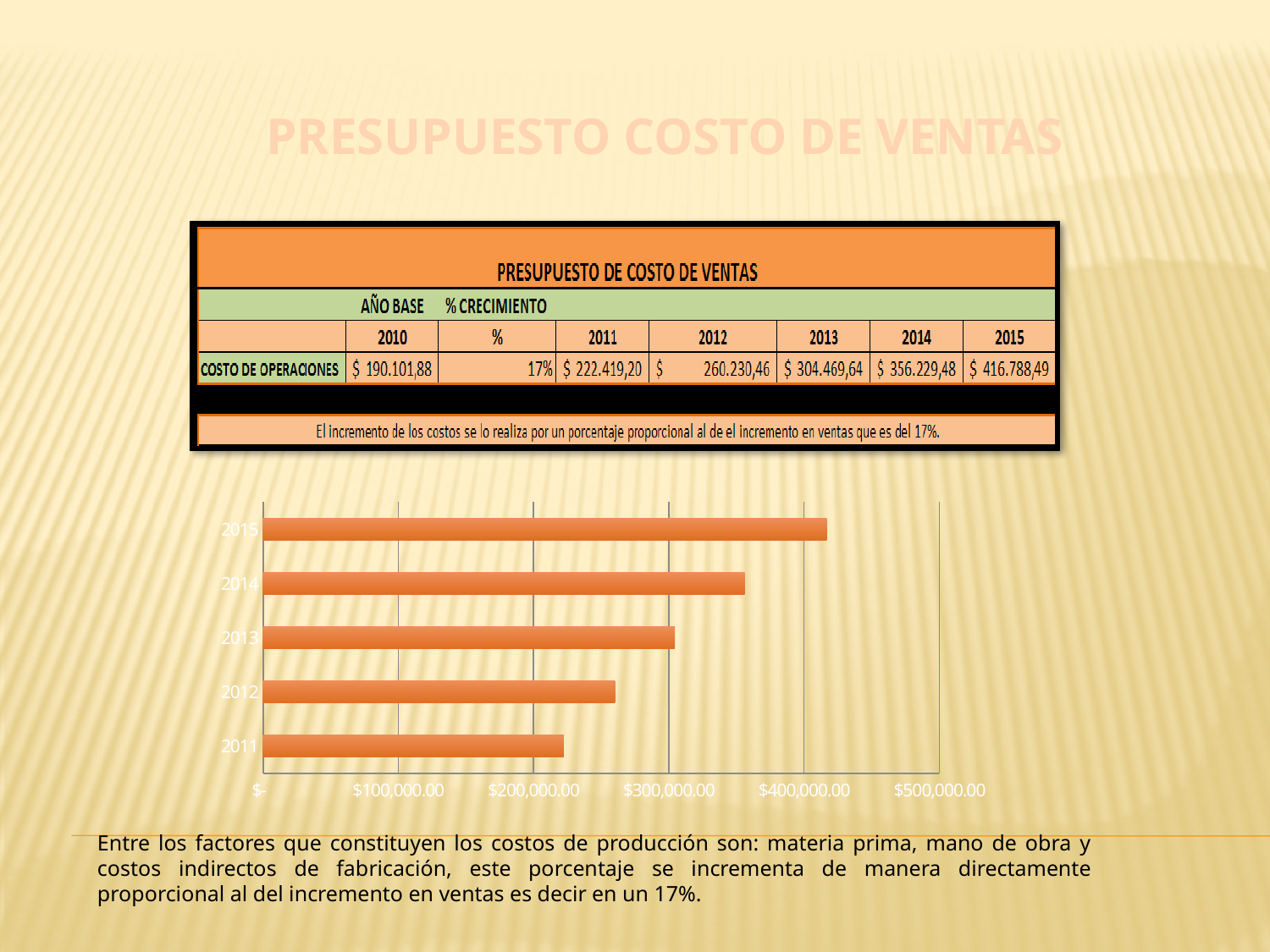
Which year has the longest bar in the chart? 2015 Is the value for 2011 in the bar chart greater or less than $200,000.00? greater In the bar chart, which is larger, the value for 2013 or the value for 2014? 2014 Is the value for 2015 in the bar chart greater or less than $400,000.00? greater Is the value for 2012 in the bar chart greater or less than $300,000.00? less How many years are plotted in the bar chart? 5 What is the highest value shown on the horizontal axis of the bar chart? $500,000.00 Which year has the shortest bar in the chart? 2011 What kind of chart is shown on the slide? bar chart Do the bar values rise or fall from 2011 to 2015? rise